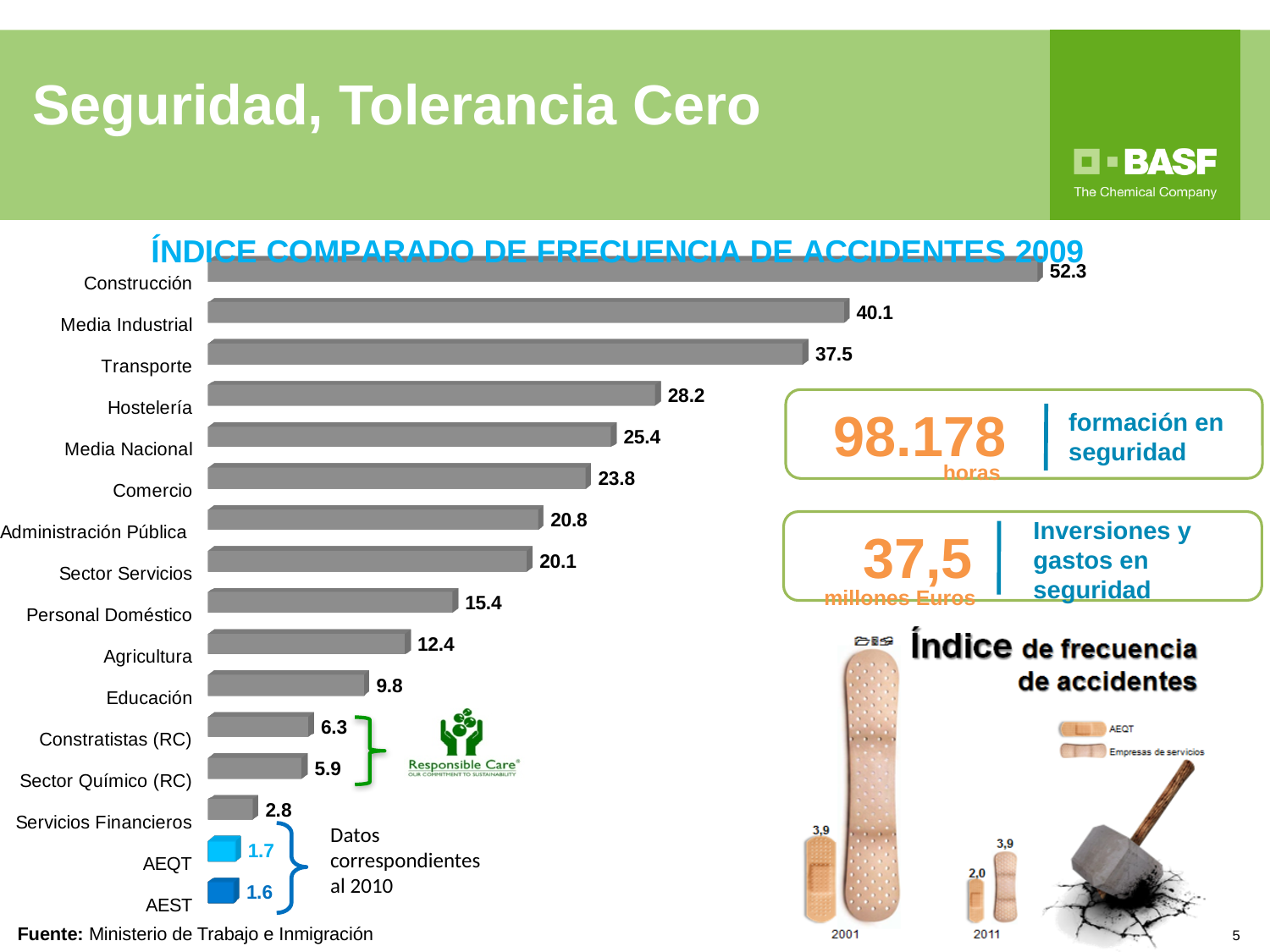
In the chart 'ÍNDICE COMPARADO DE FRECUENCIA DE ACCIDENTES 2009', what is the value for Agricultura? 12.4 In the chart 'ÍNDICE COMPARADO DE FRECUENCIA DE ACCIDENTES 2009', what is the value for Personal Doméstico? 15.4 In the chart 'ÍNDICE COMPARADO DE FRECUENCIA DE ACCIDENTES 2009', what is the value for Transporte? 37.5 In the chart 'ÍNDICE COMPARADO DE FRECUENCIA DE ACCIDENTES 2009', which category has the lowest value? AEST In the chart 'ÍNDICE COMPARADO DE FRECUENCIA DE ACCIDENTES 2009', what is the difference between Constratistas (RC) and Sector Químico (RC)? 0.4 In the chart 'ÍNDICE COMPARADO DE FRECUENCIA DE ACCIDENTES 2009', how many categories are shown? 16 In the chart 'ÍNDICE COMPARADO DE FRECUENCIA DE ACCIDENTES 2009', what is the difference between Media Industrial and Media Nacional? 14.7 What kind of chart is 'ÍNDICE COMPARADO DE FRECUENCIA DE ACCIDENTES 2009'? Bar chart In the chart 'ÍNDICE COMPARADO DE FRECUENCIA DE ACCIDENTES 2009', which category has the highest value? Construcción In the chart 'ÍNDICE COMPARADO DE FRECUENCIA DE ACCIDENTES 2009', which is larger, Hostelería or Comercio? Hostelería In the chart 'ÍNDICE COMPARADO DE FRECUENCIA DE ACCIDENTES 2009', what is the value for AEQT? 1.7